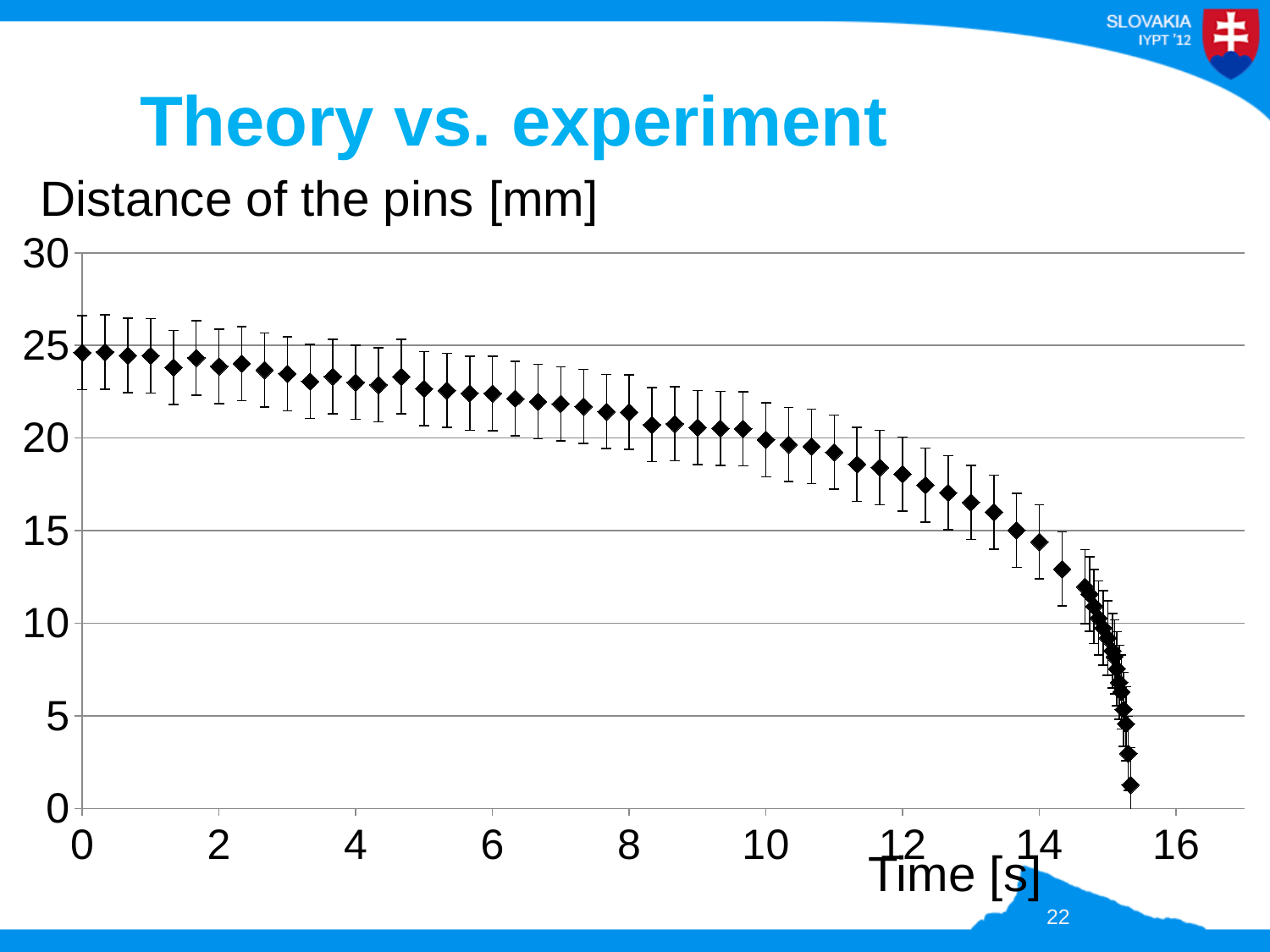
Is the value at time 12 s greater or less than 25? less Which is larger: the value at time 10 s or the value at time 14 s? the value at 10 s What quantity and unit does the vertical axis represent? Distance of the pins [mm] What is the label of the horizontal axis? Time [s] Do the plotted values rise or fall as time increases along the x axis? fall What kind of chart is shown on the slide? scatter chart Is the value at time 14 s greater or less than 20? less Which is larger: the value at time 2 s or the value at time 12 s? the value at 2 s Is the value at time 4 s greater or less than 20? greater